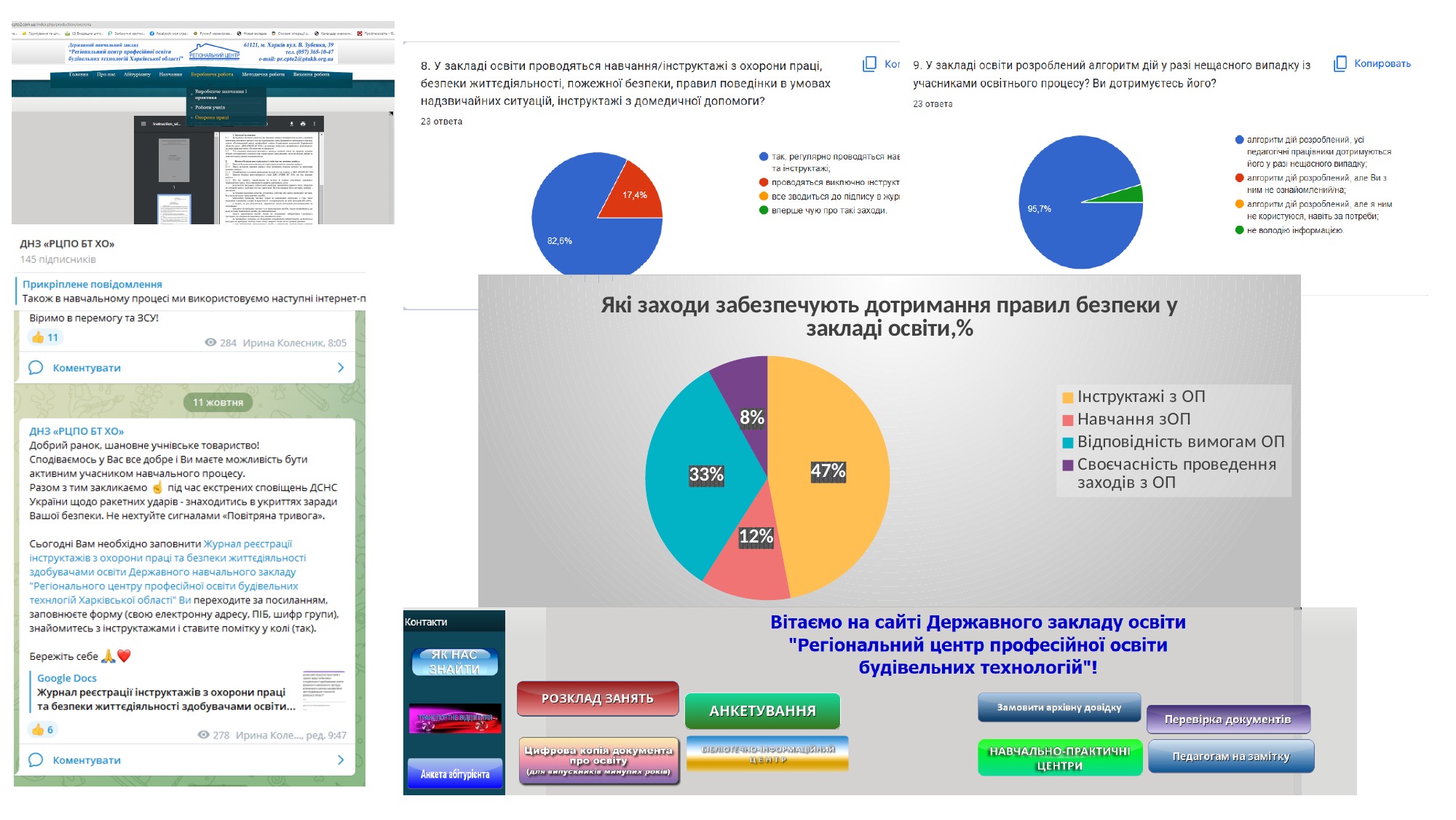
In the chart titled "Які заходи забезпечують дотримання правил безпеки у закладі освіти,%", which category has the smallest share? Своєчасність проведення заходів з ОП In the pie chart for question 8 (top middle), what is the value of the red slice? 17,4% In the chart titled "Які заходи забезпечують дотримання правил безпеки у закладі освіти,%", what is the value for "Інструктажі з ОП"? 47% In the pie chart for question 8 (top middle), what is the value of the largest slice? 82,6% In the pie chart for question 9 (top right), what is the value of the blue slice? 95,7% In the chart titled "Які заходи забезпечують дотримання правил безпеки у закладі освіти,%", what is the difference between "Інструктажі з ОП" and "Відповідність вимогам ОП"? 14% In the chart titled "Які заходи забезпечують дотримання правил безпеки у закладі освіти,%", which is larger: "Навчання зОП" or "Своєчасність проведення заходів з ОП"? Навчання зОП In the chart titled "Які заходи забезпечують дотримання правил безпеки у закладі освіти,%", what is the value for "Навчання зОП"? 12% What type of chart is the one titled "Які заходи забезпечують дотримання правил безпеки у закладі освіти,%"? pie chart In the chart titled "Які заходи забезпечують дотримання правил безпеки у закладі освіти,%", what is the value for "Відповідність вимогам ОП"? 33% In the chart titled "Які заходи забезпечують дотримання правил безпеки у закладі освіти,%", which category has the largest share? Інструктажі з ОП In the chart titled "Які заходи забезпечують дотримання правил безпеки у закладі освіти,%", how many categories does the legend list? 4